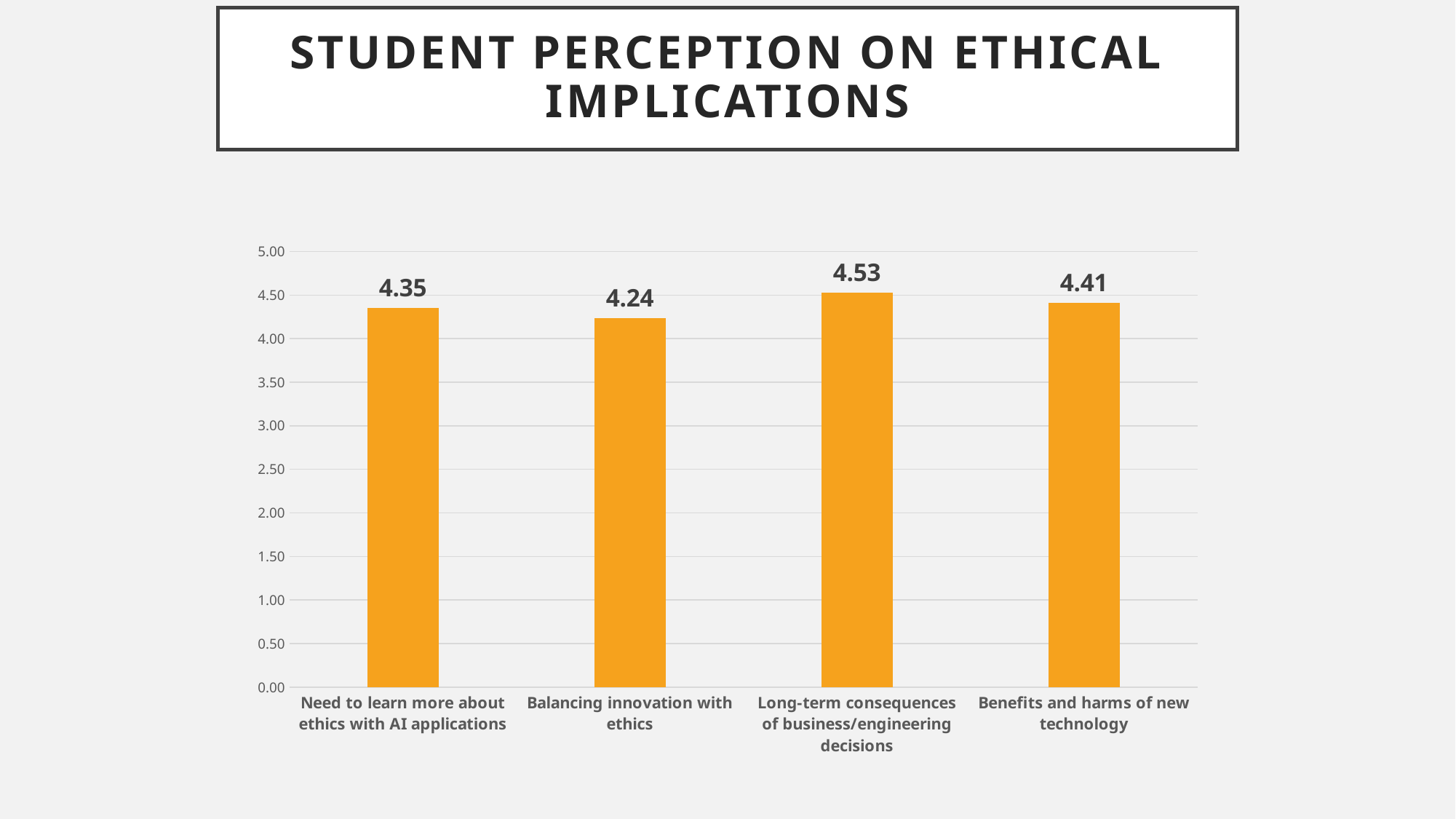
What is the value for "Need to learn more about ethics with AI applications"? 4.35 What is the value for "Benefits and harms of new technology"? 4.41 Which is larger: the value for "Benefits and harms of new technology" or the value for "Need to learn more about ethics with AI applications"? Benefits and harms of new technology Which category has the highest value? Long-term consequences of business/engineering decisions What is the title of the slide? Student Perception on Ethical Implications Is the value for "Balancing innovation with ethics" greater or less than 4.50? less Which category has the lowest value? Balancing innovation with ethics What is the value for "Balancing innovation with ethics"? 4.24 How many categories are shown in the chart? 4 What kind of chart is shown on the slide? bar chart What is the difference between the values for "Long-term consequences of business/engineering decisions" and "Balancing innovation with ethics"? 0.29 What is the value for "Long-term consequences of business/engineering decisions"? 4.53